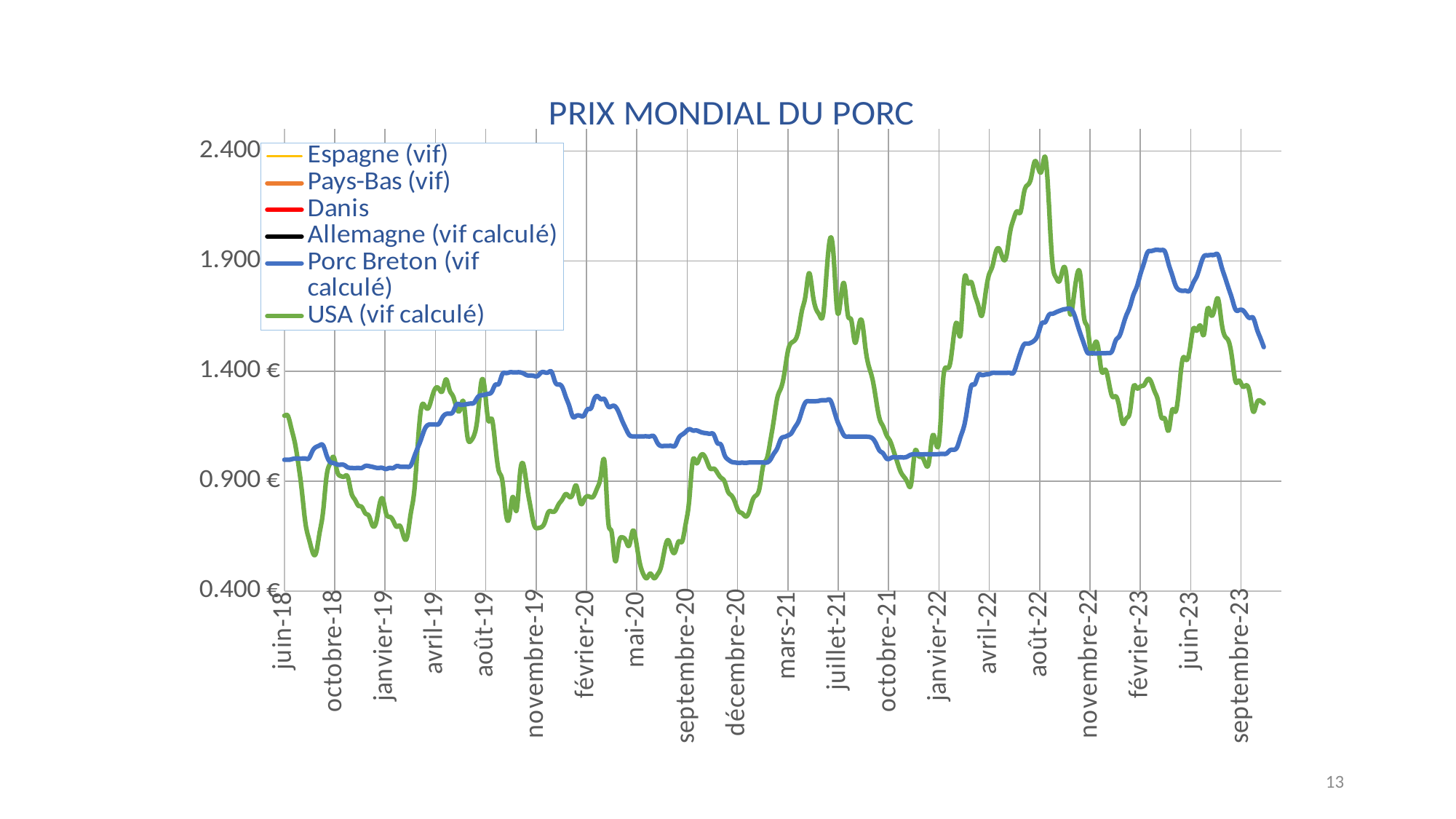
Is the value for Porc Breton (vif calculé) around août-22 greater or less than 1.400 €? greater Is the value for USA (vif calculé) around août-22 greater or less than 1.900 €? greater Which series reaches the highest value anywhere on the chart? USA (vif calculé) How many series does the legend list? 6 Around février-23, which series is higher: USA (vif calculé) or Porc Breton (vif calculé)? Porc Breton (vif calculé) Is the value for USA (vif calculé) around mai-20 greater or less than 0.900 €? less Does the Porc Breton (vif calculé) line rise or fall between janvier-22 and février-23? rise Around août-22, which series is higher: USA (vif calculé) or Porc Breton (vif calculé)? USA (vif calculé) What kind of chart is shown on the slide? line chart What is the title of the chart? PRIX MONDIAL DU PORC What colour is the line for USA (vif calculé)? green